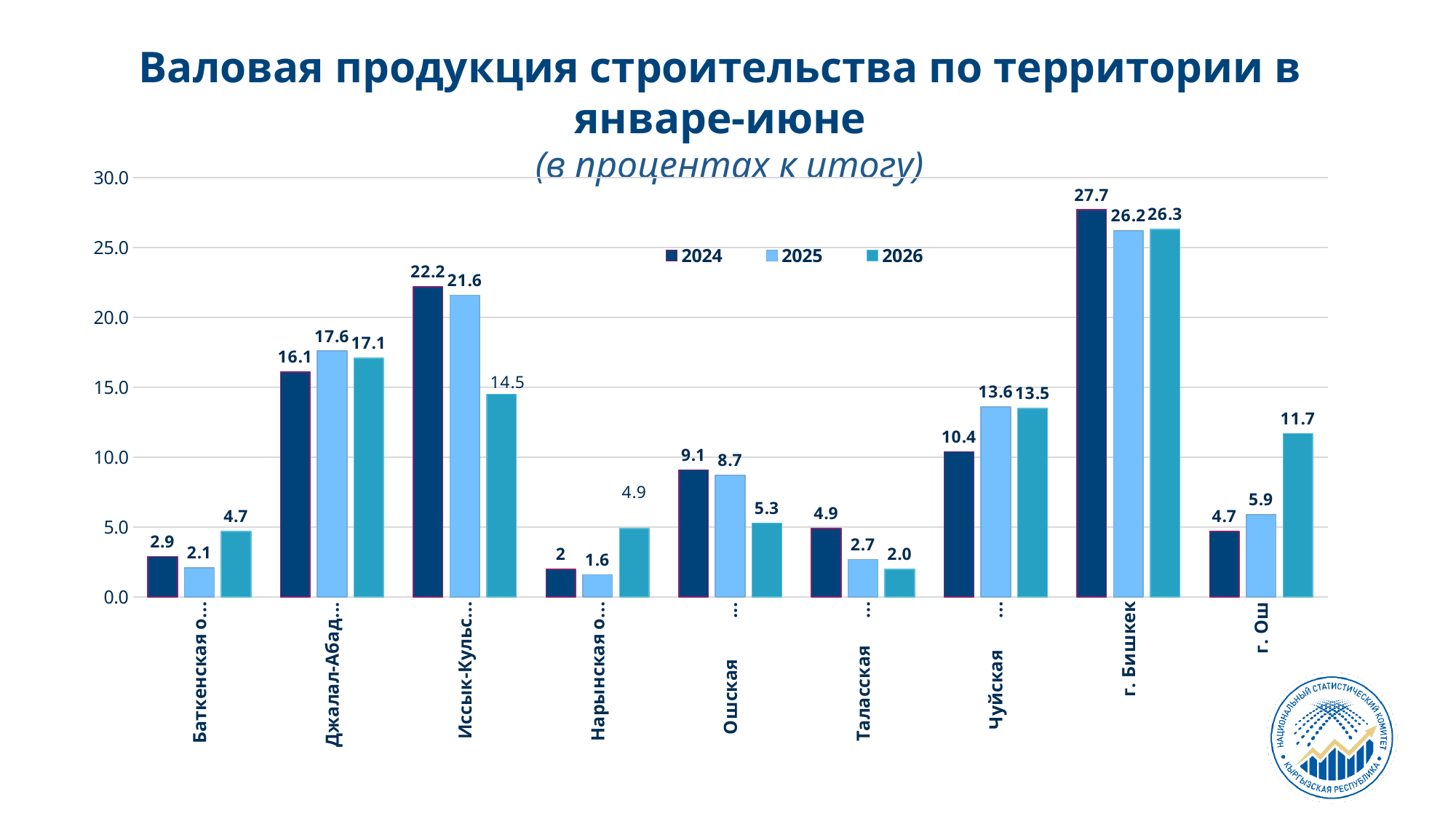
What is the value for г. Бишкек in the 2024 series? 27.7 Do the values for г. Ош rise or fall from 2024 to 2026? Rise How many series does the legend list? 3 Which category has the lowest value in the 2025 series? Нарынская What is the value for Чуйская in the 2024 series? 10.4 What is the value for Таласская in the 2025 series? 2.7 Which category has the highest value in the 2026 series? г. Бишкек What is the difference between the 2024 and 2026 values for Ошская? 3.8 How many categories are shown on the x axis? 9 What kind of chart is shown on the slide? Bar chart Which is larger for Чуйская: the 2025 value or the 2024 value? 2025 What is the value for г. Ош in the 2026 series? 11.7